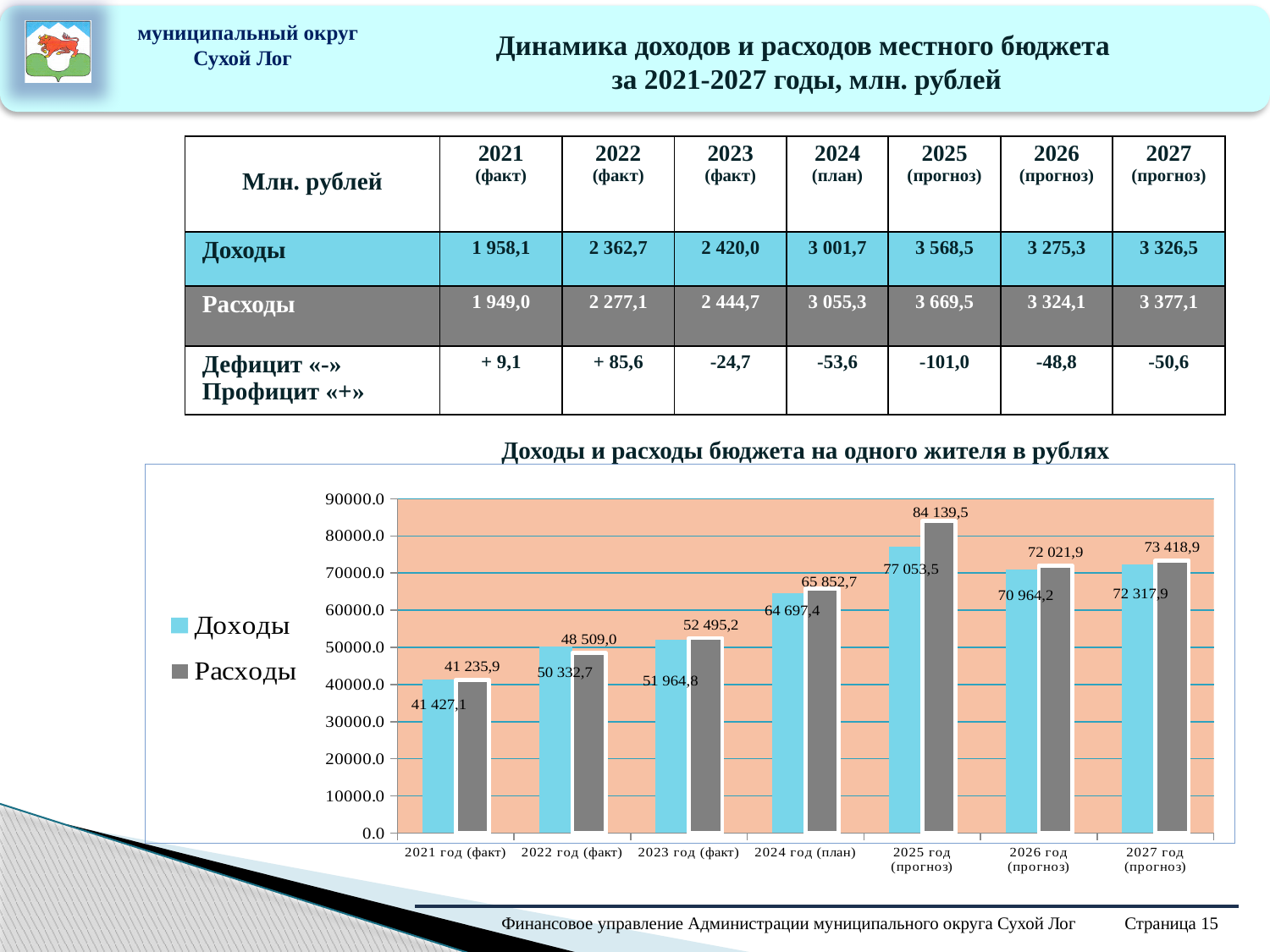
What is the value of Доходы for 2021 год (факт) in the chart 'Доходы и расходы бюджета на одного жителя в рублях'? 41 427,1 What is the value of Расходы for 2025 год (прогноз) in the chart? 84 139,5 What type of chart is 'Доходы и расходы бюджета на одного жителя в рублях'? bar chart What is the difference between Расходы and Доходы for 2025 год (прогноз) in the chart? 7 086,0 How many years (categories) are shown on the x axis of the chart? 7 In which year is Доходы lowest in the chart? 2021 год (факт) In which year is Расходы highest in the chart? 2025 год (прогноз) What is the value of Доходы for 2027 год (прогноз) in the chart? 72 317,9 What is the value of Расходы for 2023 год (факт) in the chart? 52 495,2 Which is larger for 2024 год (план) in the chart, Доходы or Расходы? Расходы Is the value of Доходы for 2026 год (прогноз) greater or less than 80000.0? less How many series does the chart legend list? 2